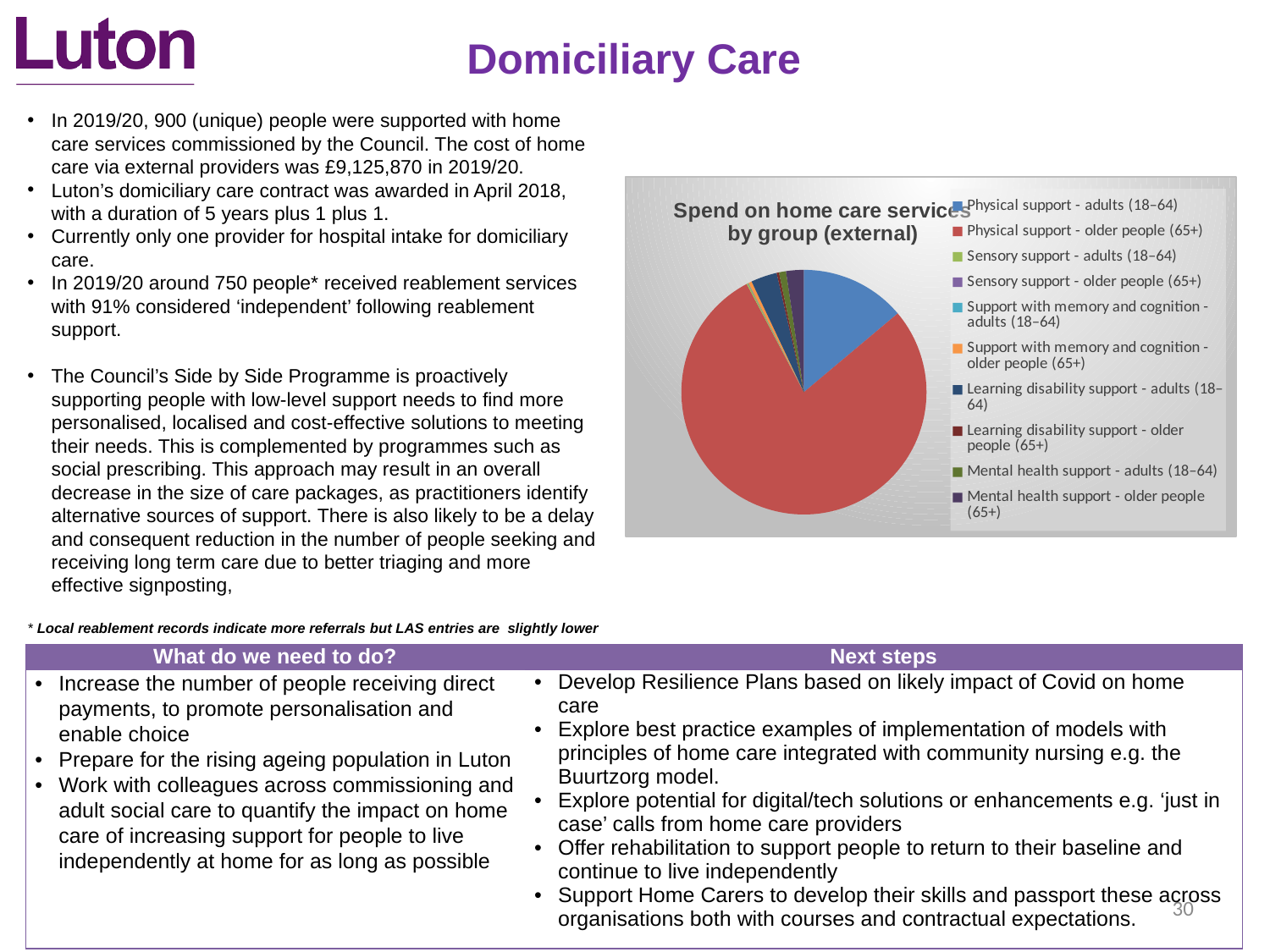
Which is larger in the pie chart: the slice for Physical support - older people (65+) or the slice for Physical support - adults (18–64)? Physical support - older people (65+) Which group accounts for the largest share of spend on home care services in the pie chart? Physical support - older people (65+) Which is larger in the pie chart: the slice for Physical support - adults (18–64) or the slice for Learning disability support - adults (18–64)? Physical support - adults (18–64) How many groups does the chart's legend list? 10 Does the slice for Physical support - older people (65+) take up more or less than half of the pie? more What colour is the slice for Physical support - older people (65+) in the pie chart? red Which group has the second-largest slice in the pie chart? Physical support - adults (18–64) What is the title of the chart on the slide? Spend on home care services by group (external) What kind of chart is shown on the slide? pie chart